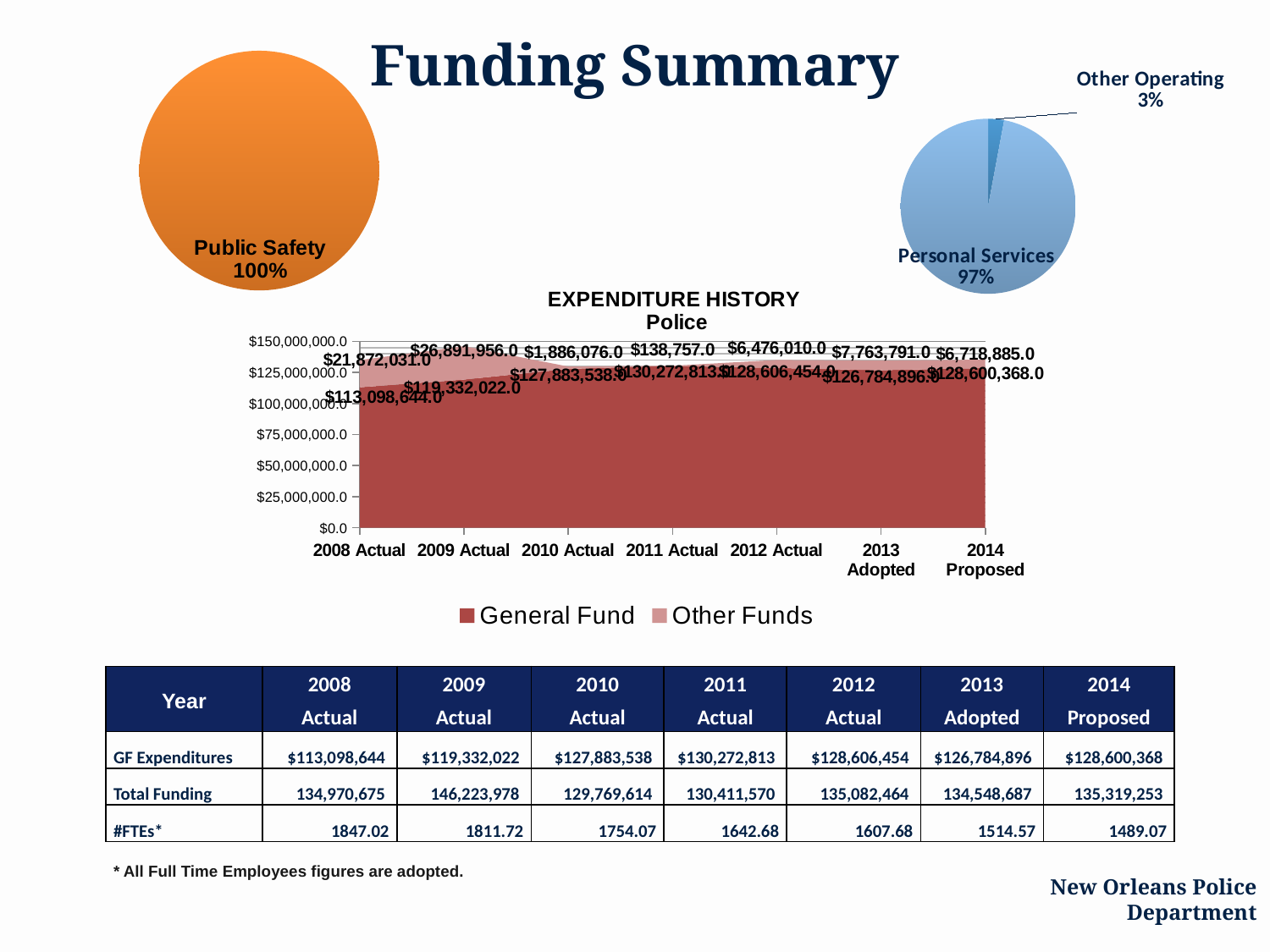
In the EXPENDITURE HISTORY Police chart, which year has the highest General Fund value? 2011 Actual How many series does the legend of the EXPENDITURE HISTORY Police chart list? 2 In the EXPENDITURE HISTORY Police chart, what is the Other Funds value for 2011 Actual? $138,757.0 In the EXPENDITURE HISTORY Police chart, what is the General Fund value for 2008 Actual? $113,098,644.0 In the EXPENDITURE HISTORY Police chart, which is larger: the Other Funds value for 2012 Actual or for 2013 Adopted? 2013 Adopted In the EXPENDITURE HISTORY Police chart, is the General Fund value for 2009 Actual greater or less than $125,000,000.0? less How many years are shown on the x axis of the EXPENDITURE HISTORY Police chart? 7 In the EXPENDITURE HISTORY Police chart, what is the General Fund value for 2014 Proposed? $128,600,368.0 In the EXPENDITURE HISTORY Police chart, what is the Other Funds value for 2009 Actual? $26,891,956.0 In the pie chart at the top right, what share does Personal Services have? 97% In the EXPENDITURE HISTORY Police chart, which year has the lowest Other Funds value? 2011 Actual In the pie chart at the top left, what share does Public Safety have? 100%